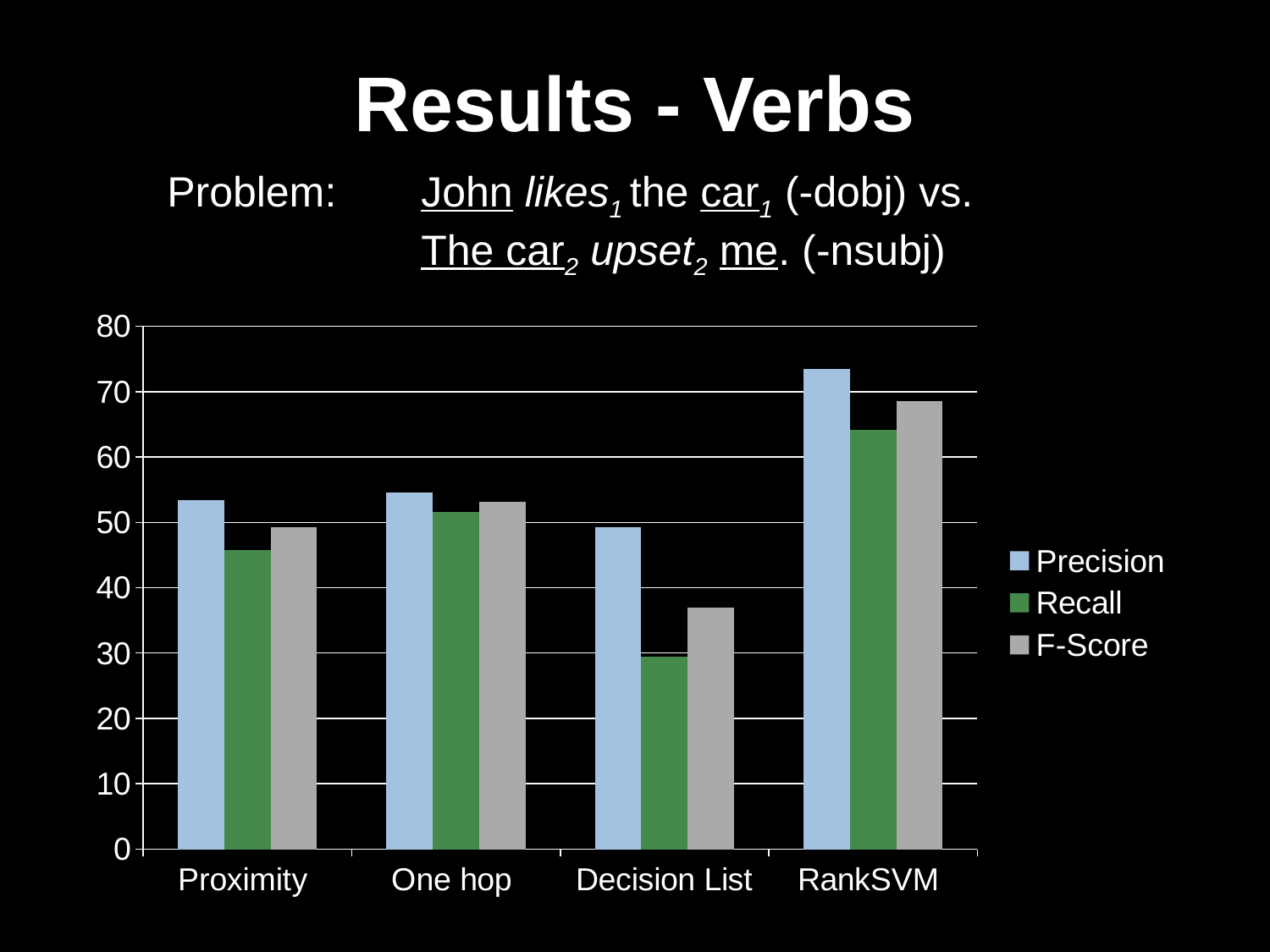
What colour represents the Recall series in the chart? green Is the Precision value for RankSVM greater or less than 70? greater Which category has the highest F-Score? RankSVM How many categories are shown on the x axis of the chart? 4 Which has the larger Precision, One hop or Decision List? One hop What kind of chart is shown on the slide? bar chart Is the Recall value for RankSVM greater or less than 60? greater Is the Recall value for Decision List greater or less than 40? less Which category has the lowest Recall? Decision List Which category has the highest Precision? RankSVM How many series does the chart's legend list? 3